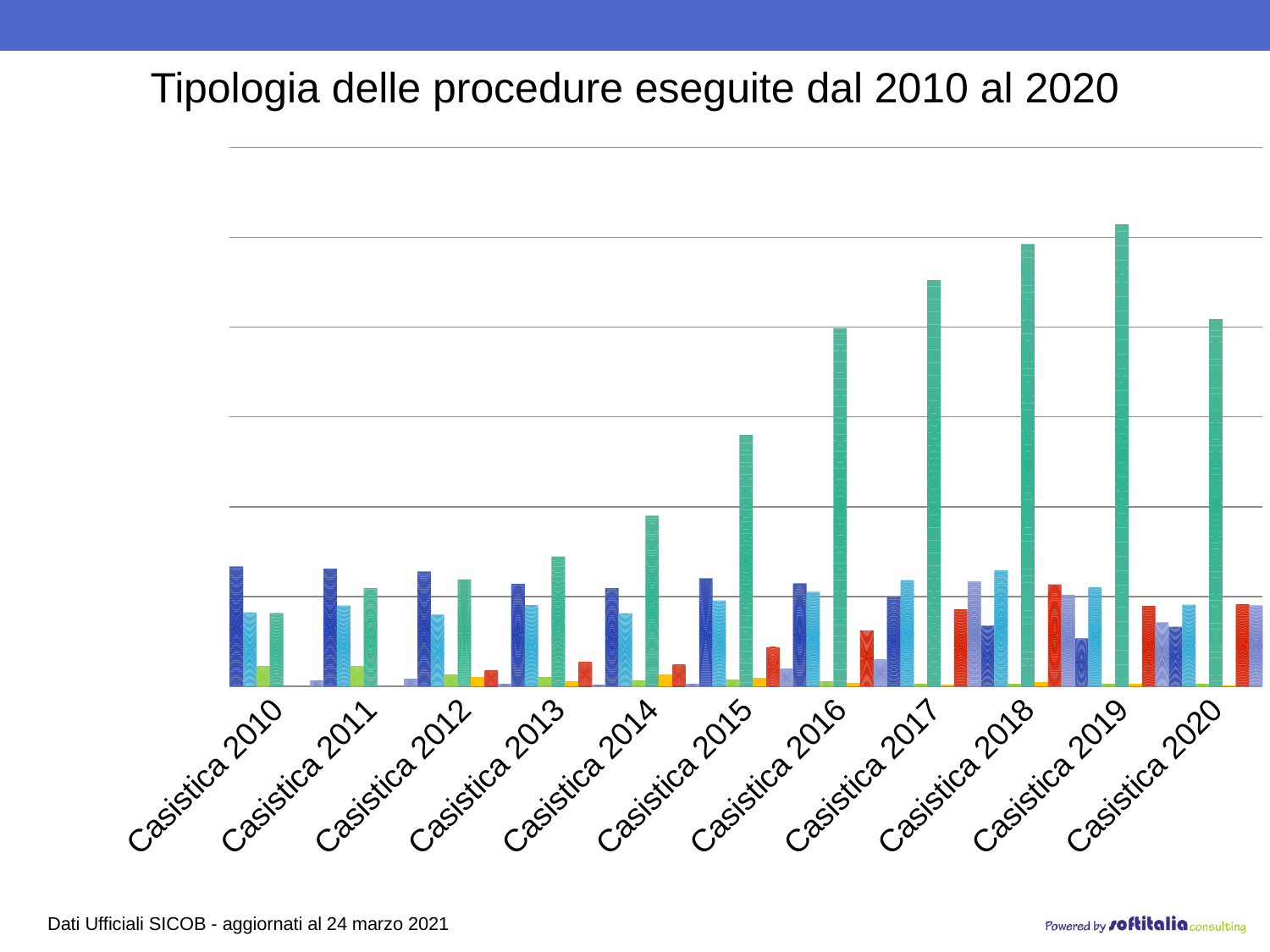
What data source note is printed at the bottom of the slide? Dati Ufficiali SICOB - aggiornati al 24 marzo 2021 Does the green bar generally rise or fall from Casistica 2010 to Casistica 2019? Rise How many categories are shown along the x axis of the chart? 11 What kind of chart is shown on the slide? Bar chart Which category has the taller green bar, Casistica 2012 or Casistica 2014? Casistica 2014 Which category contains the tallest bar in the chart? Casistica 2019 Is the tallest bar for Casistica 2019 taller or shorter than the tallest bar for Casistica 2020? Taller Which category has the taller green bar, Casistica 2017 or Casistica 2018? Casistica 2018 What is the title of the chart? Tipologia delle procedure eseguite dal 2010 al 2020